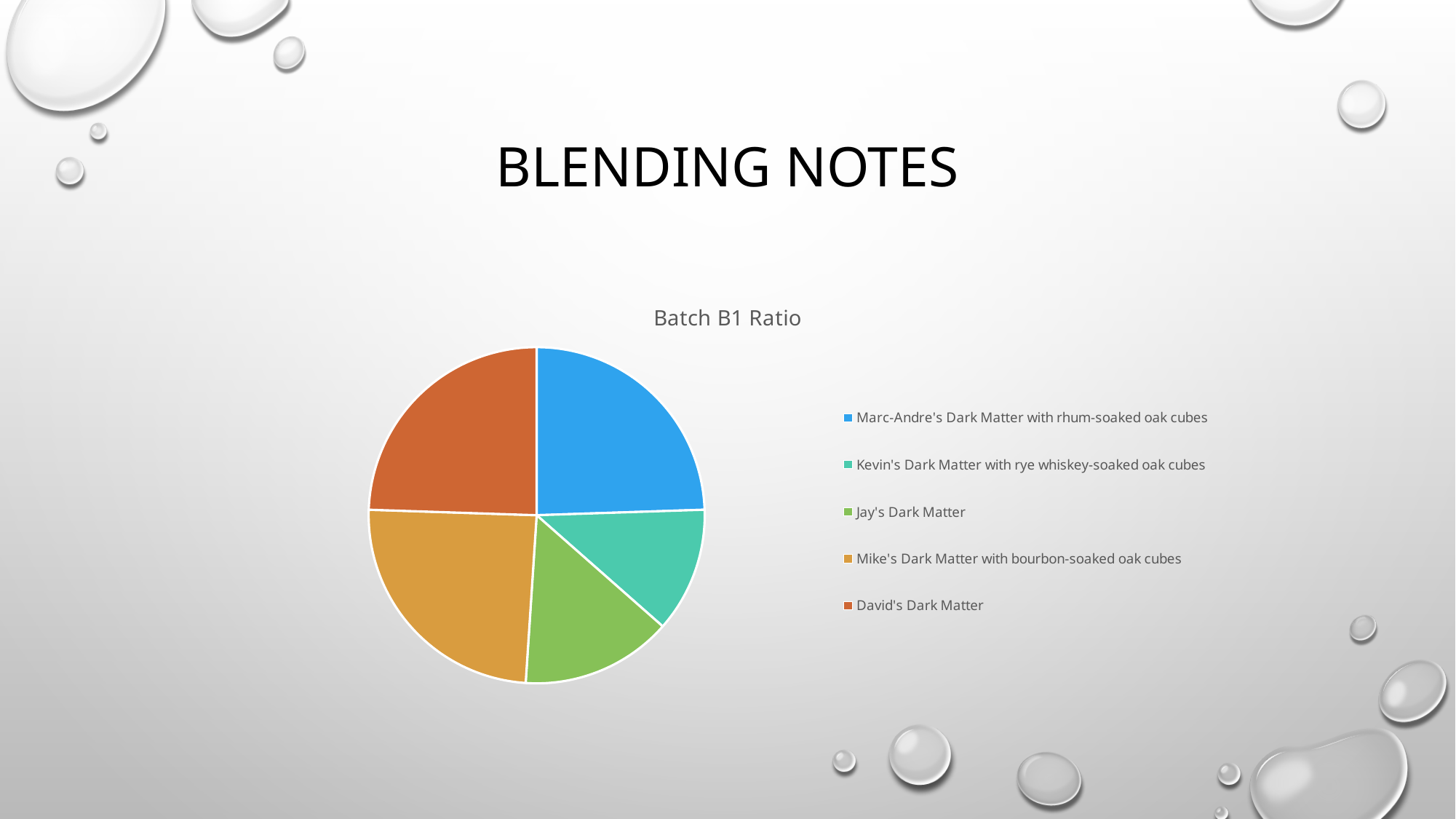
What is the title of the chart? Batch B1 Ratio How many entries does the legend list? 5 Which slice is larger: Mike's Dark Matter with bourbon-soaked oak cubes or Jay's Dark Matter? Mike's Dark Matter with bourbon-soaked oak cubes What kind of chart is shown on the slide? pie chart What colour is the slice for Jay's Dark Matter? green How many slices does the pie chart have? 5 Which slice is larger: David's Dark Matter or Kevin's Dark Matter with rye whiskey-soaked oak cubes? David's Dark Matter Which slice is larger: Jay's Dark Matter or David's Dark Matter? David's Dark Matter